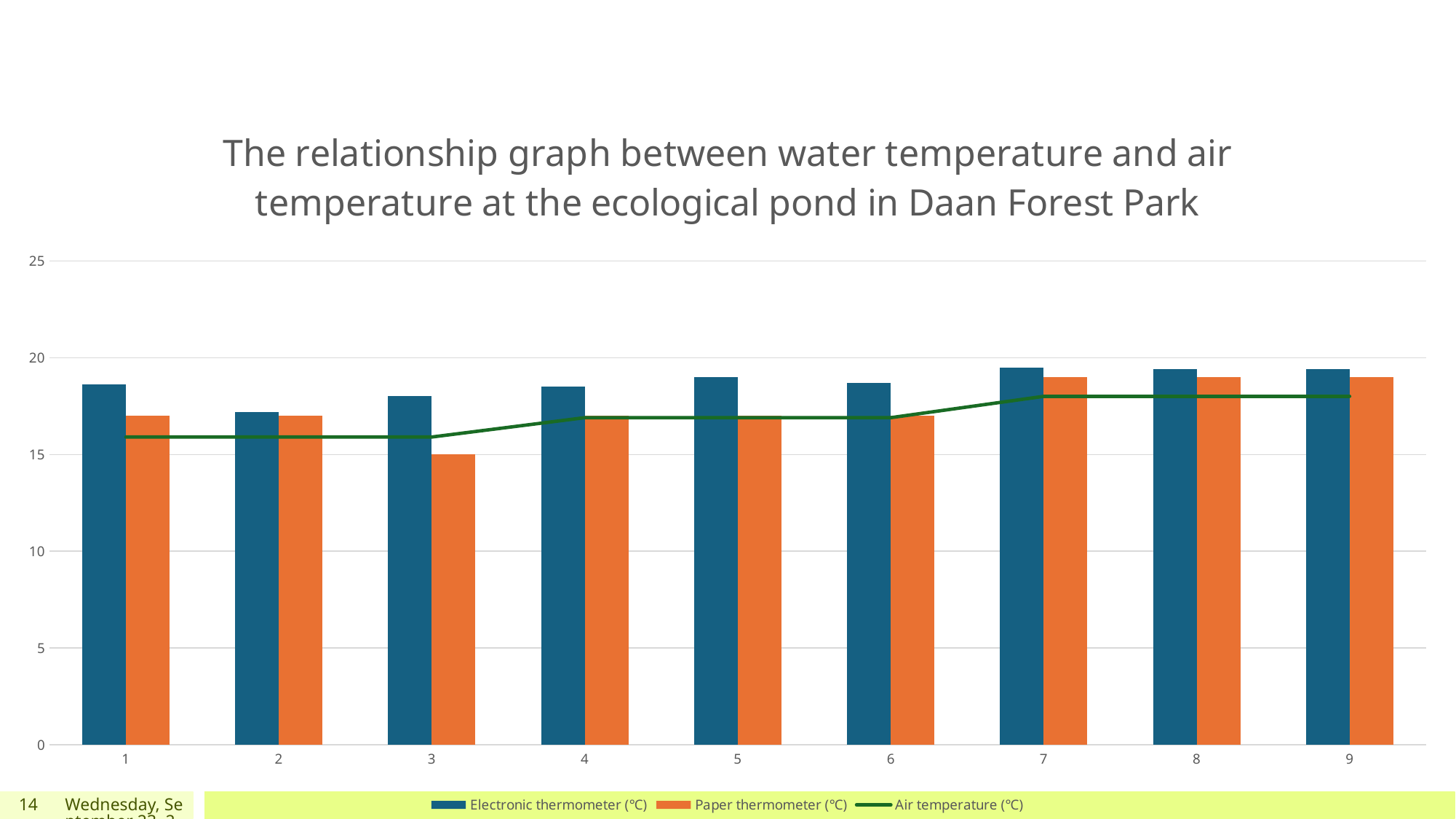
Which series is drawn as a line rather than bars? Air temperature (℃) How many series does the chart's legend list? 3 For which category is the Electronic thermometer (℃) value lowest? 2 Is the Electronic thermometer (℃) value for category 7 greater or less than 20? less For which category is the Paper thermometer (℃) value lowest? 3 How many categories are shown on the x axis of the chart? 9 What is the title of the chart? The relationship graph between water temperature and air temperature at the ecological pond in Daan Forest Park At category 3, which is larger: the Electronic thermometer (℃) value or the Paper thermometer (℃) value? Electronic thermometer (℃) Is the Electronic thermometer (℃) value for category 1 greater or less than 15? greater Is the Air temperature (℃) value for category 9 greater or less than 20? less Does the Air temperature (℃) line rise or fall from category 1 to category 9? rise